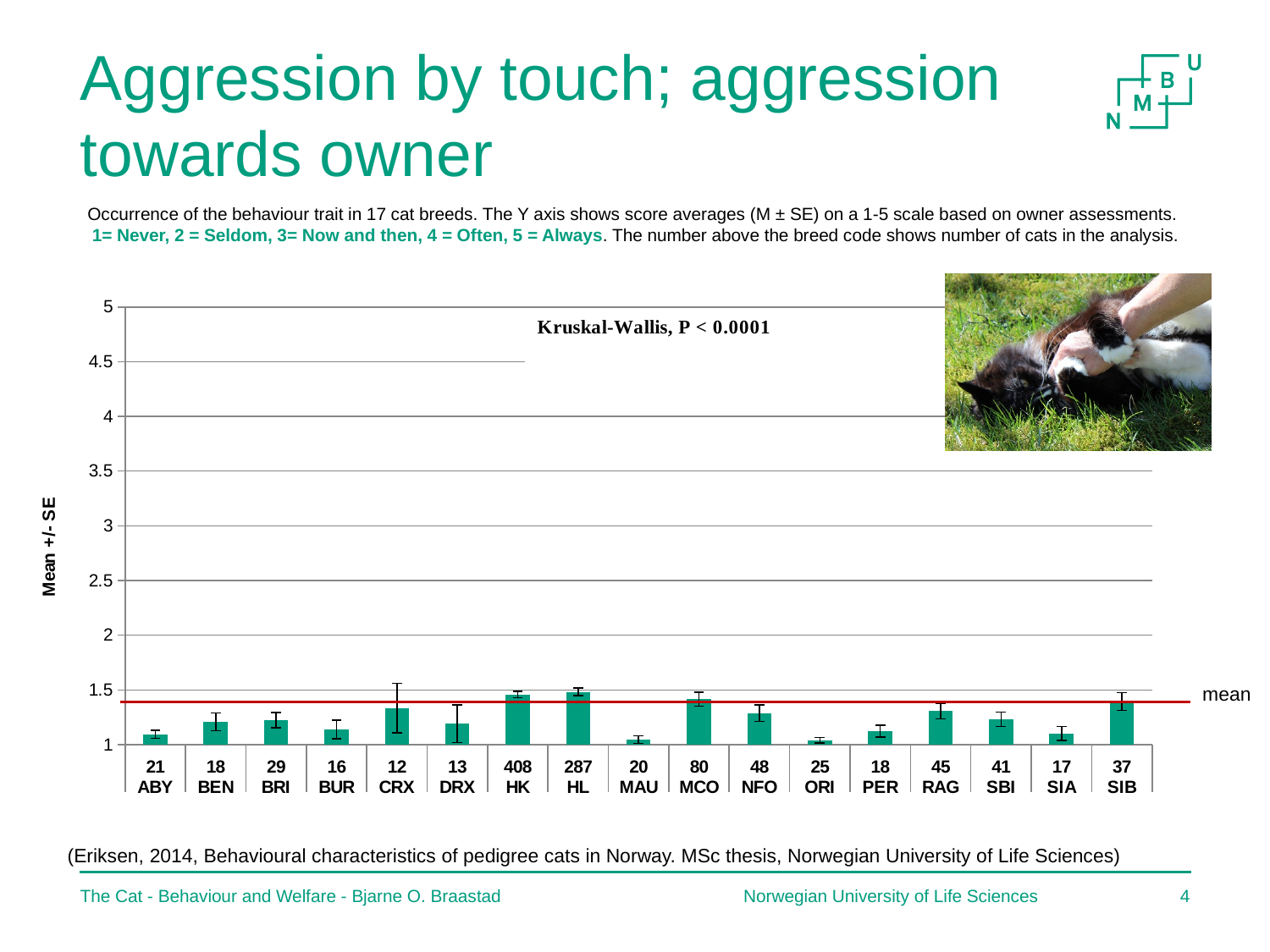
Is the value for MAU greater or less than 1.5? less What kind of chart is shown on the slide? bar chart What is the highest value shown on the y axis? 5 Which has the larger value, HK or MAU? HK Is the value for SIB greater or less than 2? less Which has the larger value, ORI or MCO? MCO Which has the larger value, BUR or CRX? CRX How many cat breeds are plotted along the x axis? 17 What is the label on the y axis? Mean +/- SE Is the value for ORI greater or less than 1.5? less How many cats were in the analysis for the HK breed, according to the number above the breed code? 408